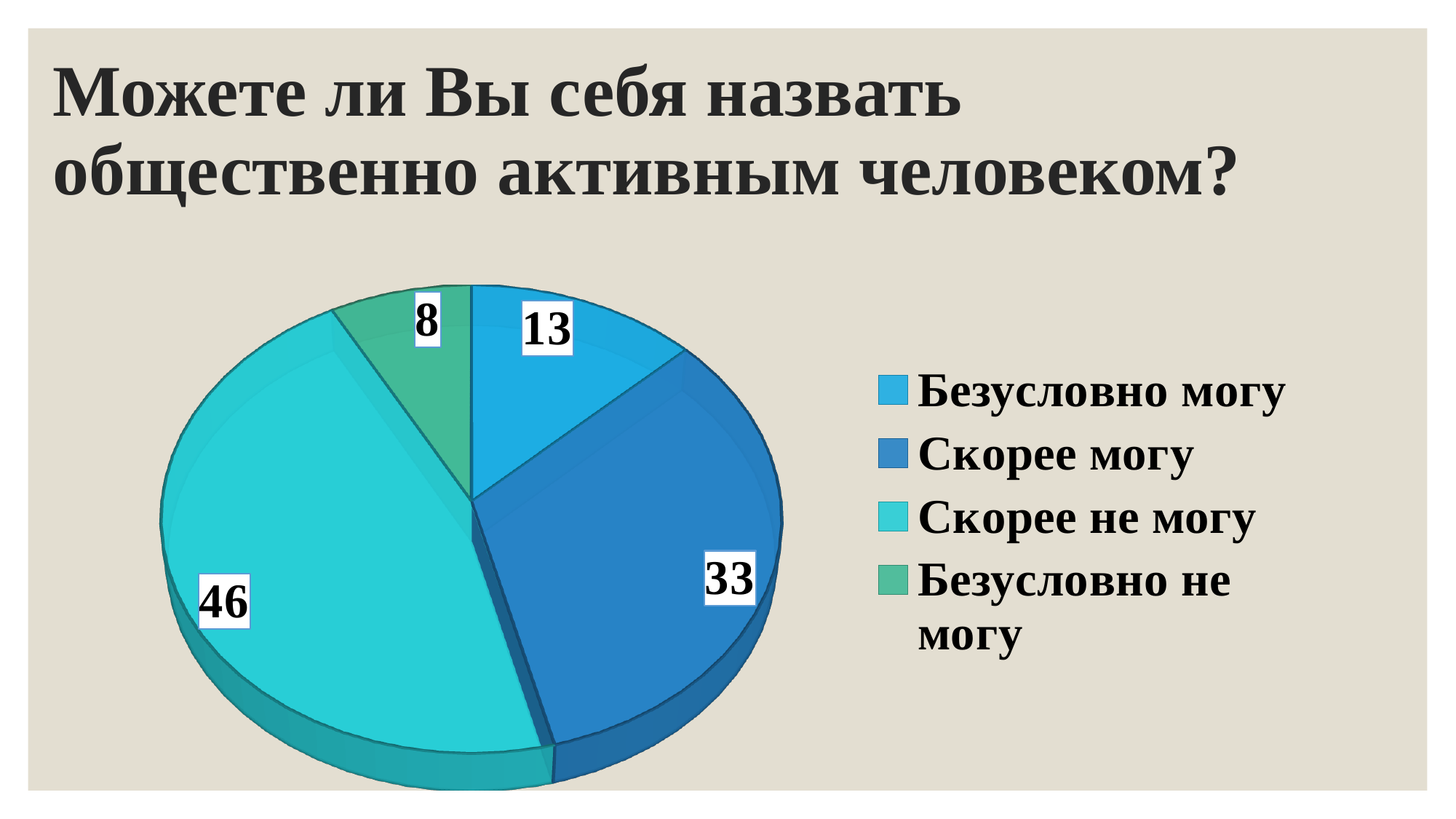
Which category has the largest slice? Скорее не могу What is the title of the slide above the chart? Можете ли Вы себя назвать общественно активным человеком? Which category has the smallest slice? Безусловно не могу Which is larger, the value for "Безусловно могу" or the value for "Безусловно не могу"? Безусловно могу What is the value for "Безусловно могу"? 13 What kind of chart is shown on the slide? pie chart What is the value for "Безусловно не могу"? 8 What is the value for "Скорее могу"? 33 How many categories does the pie chart have? 4 What is the difference between the values for "Скорее не могу" and "Скорее могу"? 13 What is the total of all the slice values? 100 What is the value for "Скорее не могу"? 46